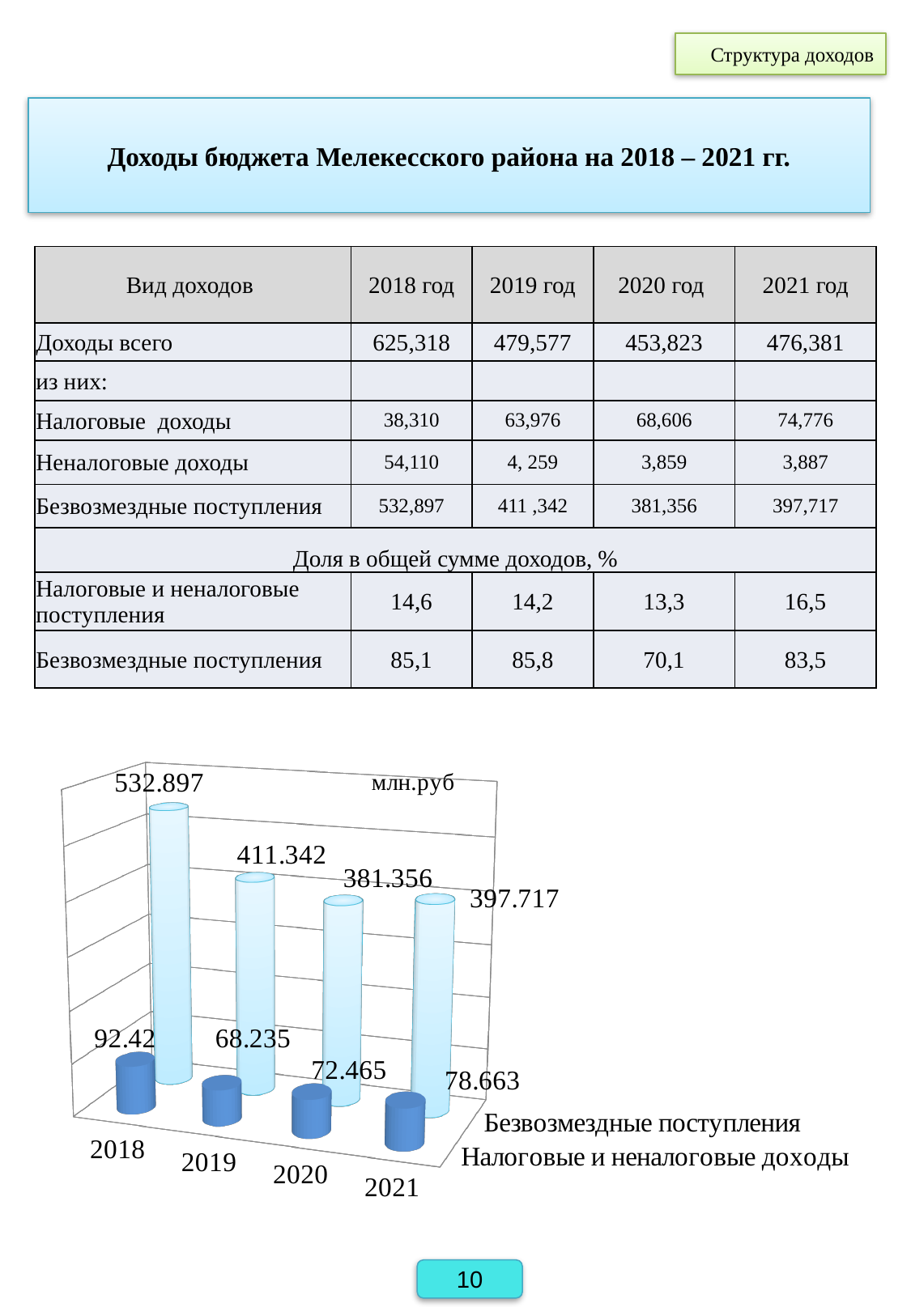
In the chart, what is the difference between Безвозмездные поступления in 2018 and 2019? 121.555 How many series does the chart show? 2 In the chart, what is the value for Безвозмездные поступления in 2021? 397.717 In the chart, what is the difference between Налоговые и неналоговые доходы in 2018 and 2019? 24.185 In the chart, what is the value for Налоговые и неналоговые доходы in 2019? 68.235 In the chart, what is the value for Безвозмездные поступления in 2018? 532.897 In the chart, which year has the highest value for Безвозмездные поступления? 2018 How many years are shown on the x axis of the chart? 4 In the chart, which year has the lowest value for Налоговые и неналоговые доходы? 2019 In the chart, which is larger: Безвозмездные поступления in 2020 or in 2021? 2021 What type of chart is shown at the bottom of the slide? bar chart In the chart, what is the value for Налоговые и неналоговые доходы in 2020? 72.465